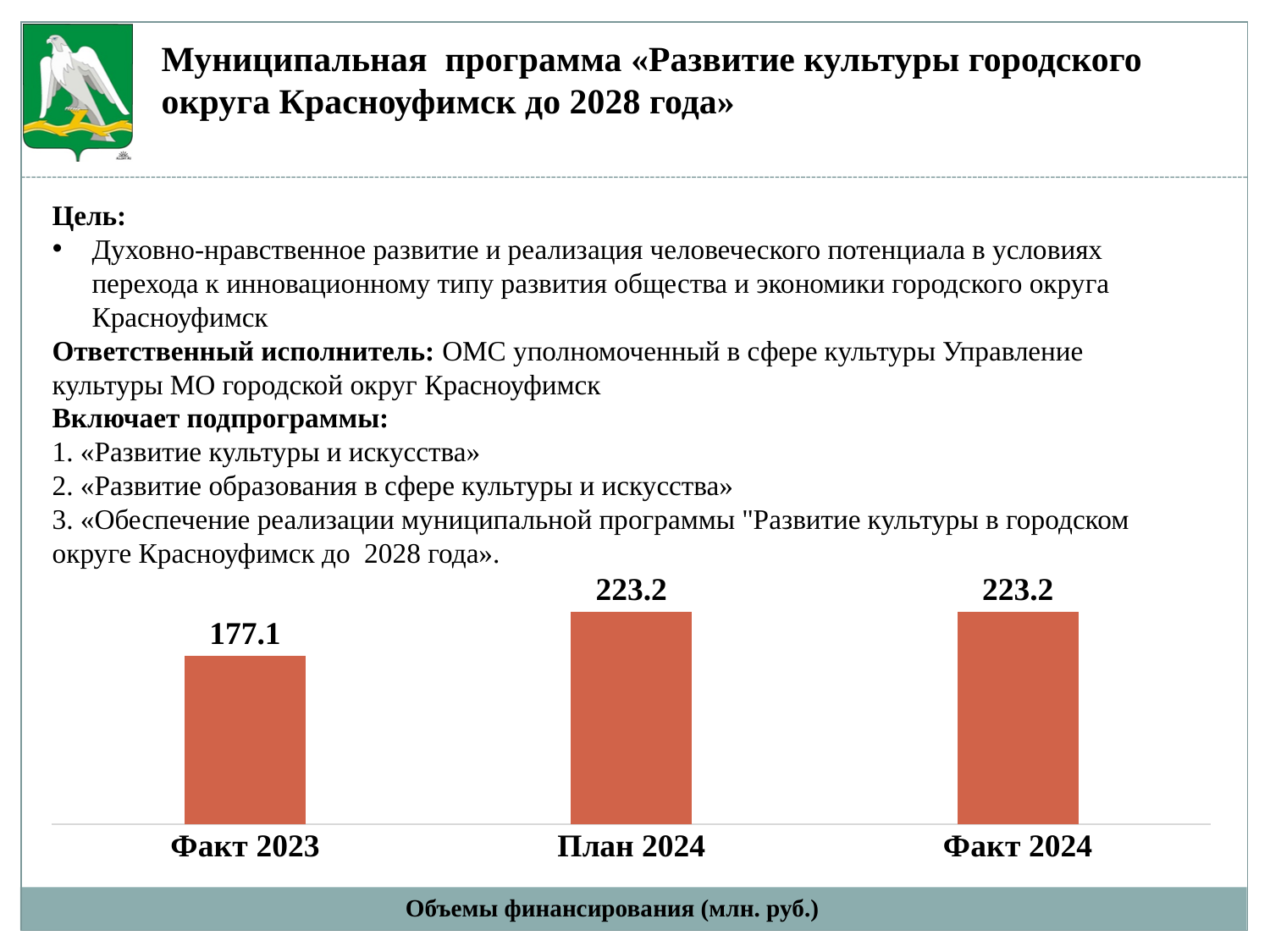
What is the value for Факт 2024? 223.2 What kind of chart is shown on the slide? bar chart What is the difference between План 2024 and Факт 2023? 46.1 What is the value for Факт 2023? 177.1 How many bars are shown in the chart? 3 Which category has the lowest value? Факт 2023 Do the values rise or fall from Факт 2023 to План 2024? rise What is the caption below the chart? Объемы финансирования (млн. руб.) Are the values for План 2024 and Факт 2024 equal? yes What is the value for План 2024? 223.2 Which is larger, Факт 2023 or Факт 2024? Факт 2024 Is the value for Факт 2023 greater or less than 200? less